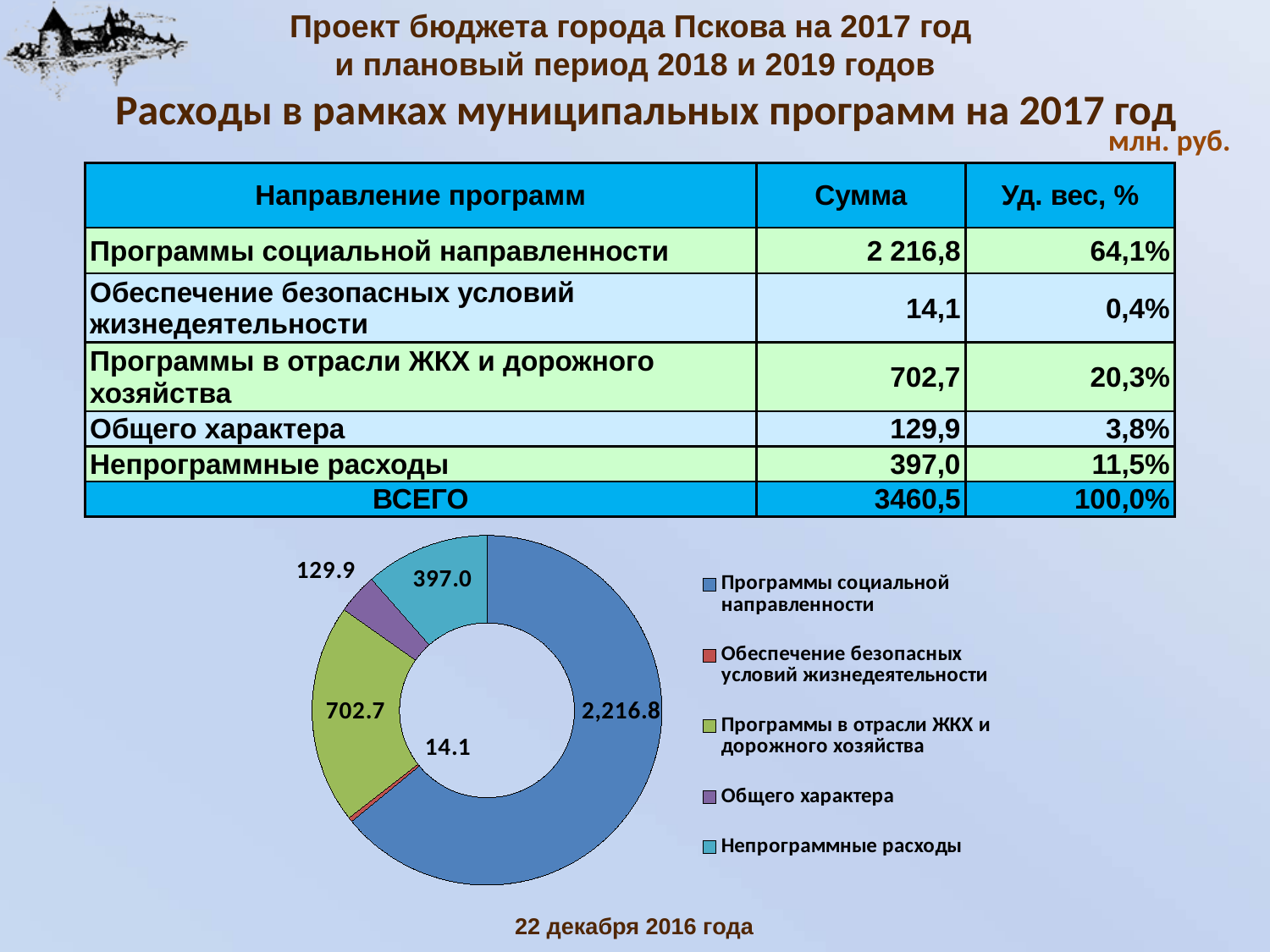
What value is shown on the chart for Программы в отрасли ЖКХ и дорожного хозяйства? 702.7 What value is shown on the chart for Общего характера? 129.9 What value is shown on the chart for Обеспечение безопасных условий жизнедеятельности? 14.1 What value is shown on the chart for Непрограммные расходы? 397.0 Which is larger in the chart: Непрограммные расходы or Общего характера? Непрограммные расходы What share of the total do Программы социальной направленности represent, according to the slide? 64,1% What is the difference between the chart values for Программы в отрасли ЖКХ и дорожного хозяйства and Непрограммные расходы? 305.7 Which category has the largest slice in the chart? Программы социальной направленности How many categories does the chart legend list? 5 Which category has the smallest slice in the chart? Обеспечение безопасных условий жизнедеятельности What kind of chart is shown on the slide? doughnut chart What value is shown on the chart for Программы социальной направленности? 2,216.8